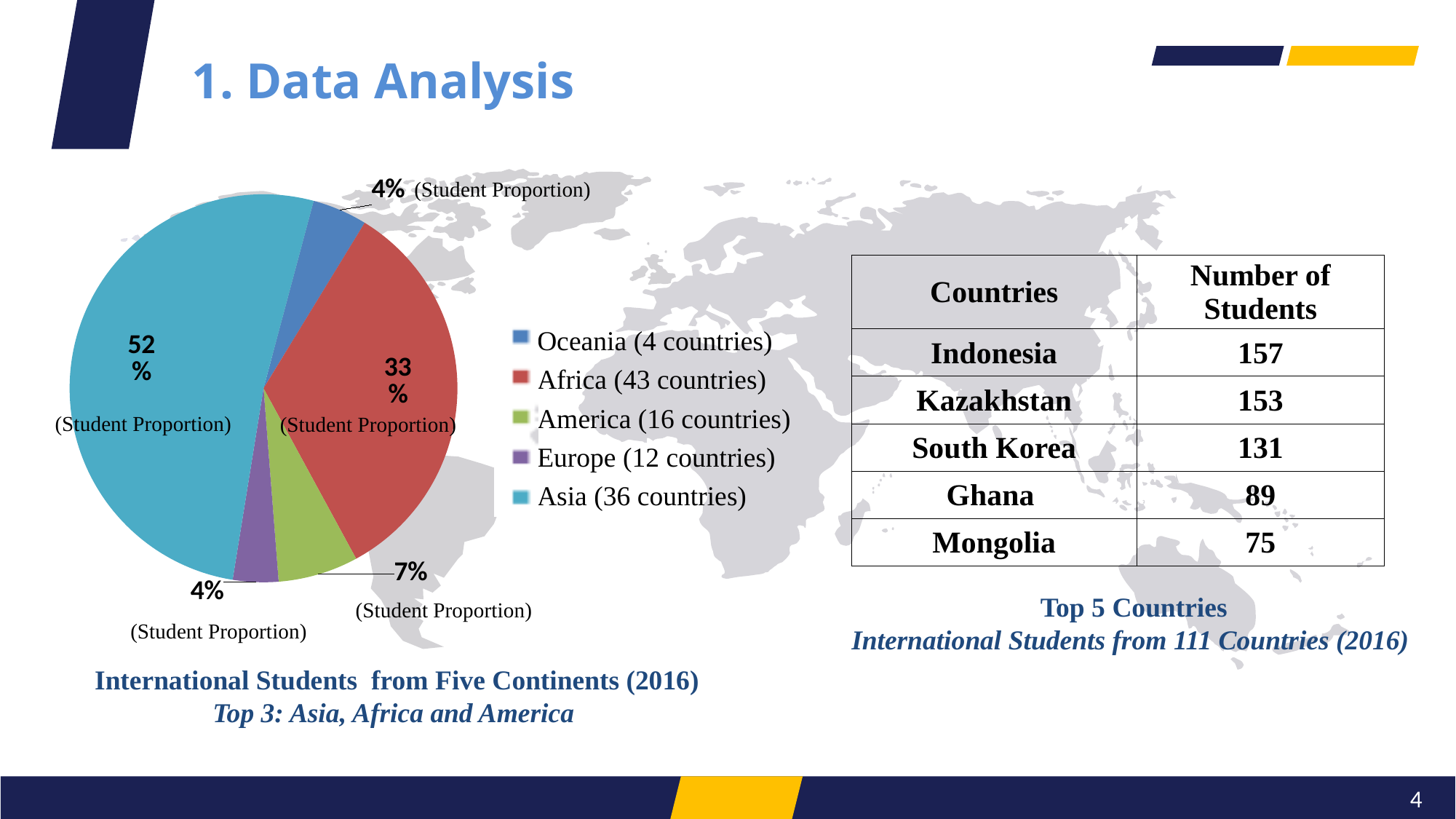
Which slice is larger, Africa (43 countries) or America (16 countries)? Africa (43 countries) Which continent has the largest slice of the pie? Asia (36 countries) What share of the pie does America (16 countries) have? 7% What share of the pie does Asia (36 countries) have? 52% What is the caption below the pie chart? International Students from Five Continents (2016) Top 3: Asia, Africa and America What share of the pie does Europe (12 countries) have? 4% What kind of chart is shown on the slide? pie chart What colour is the Asia (36 countries) slice in the pie chart? teal/light blue How many entries does the legend of the pie chart list? 5 What is the difference in percentage points between the Asia slice and the Africa slice? 19 How many slices does the pie chart have? 5